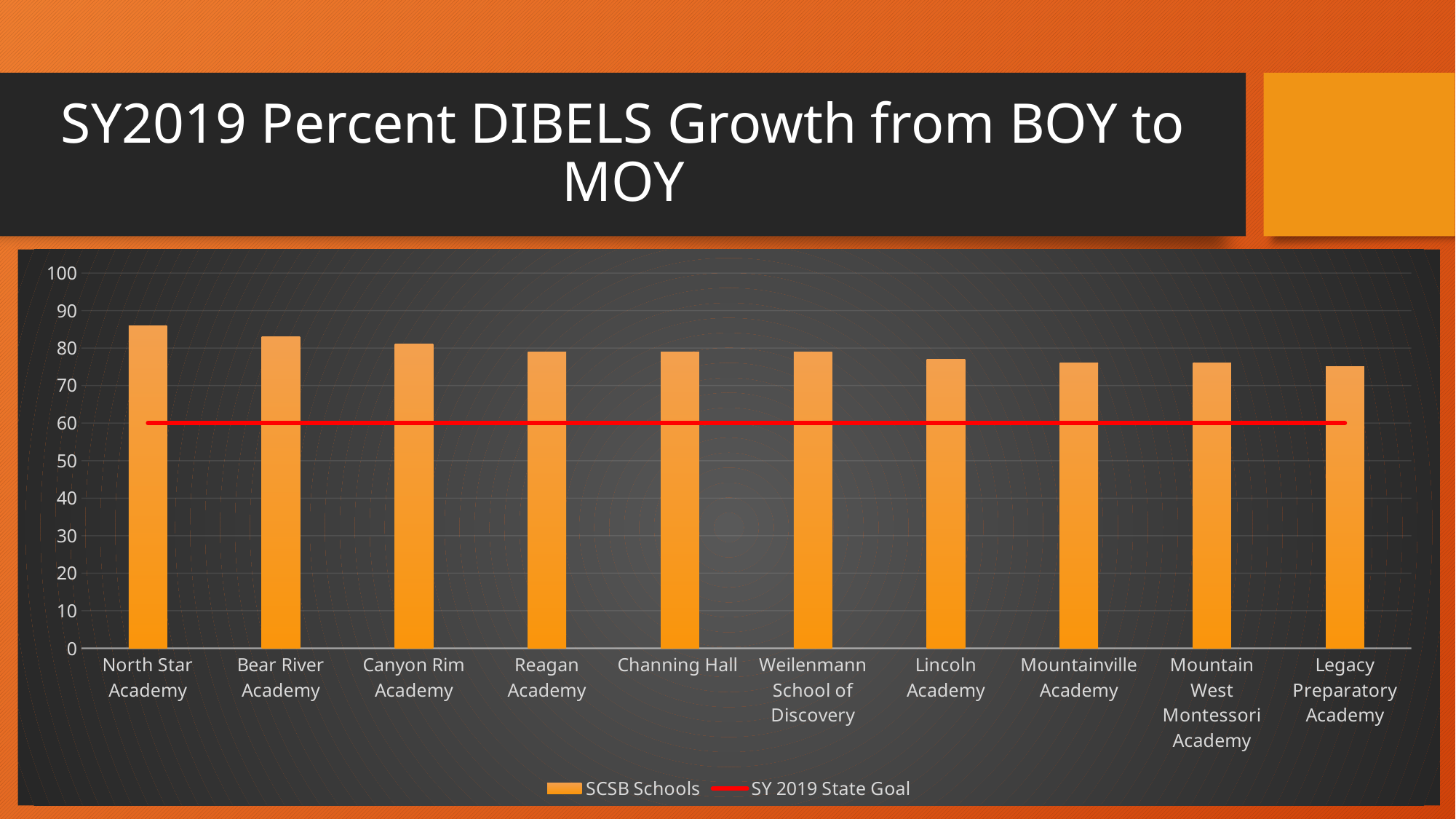
Which is larger, the value for North Star Academy or the value for Legacy Preparatory Academy? North Star Academy How many schools are shown on the x axis of the chart? 10 How many series does the chart legend list? 2 Do the bar values generally rise or fall from left to right along the x axis? fall Is the value for North Star Academy greater or less than 80? greater What value does the SY 2019 State Goal line sit at? 60 What kind of chart is shown on the slide? bar chart Is the value for Lincoln Academy greater or less than 60? greater Which school has the highest percent DIBELS growth in the chart? North Star Academy Is the value for Legacy Preparatory Academy greater or less than 80? less What does the red line in the chart represent according to the legend? SY 2019 State Goal What is the title of the chart on the slide? SY2019 Percent DIBELS Growth from BOY to MOY